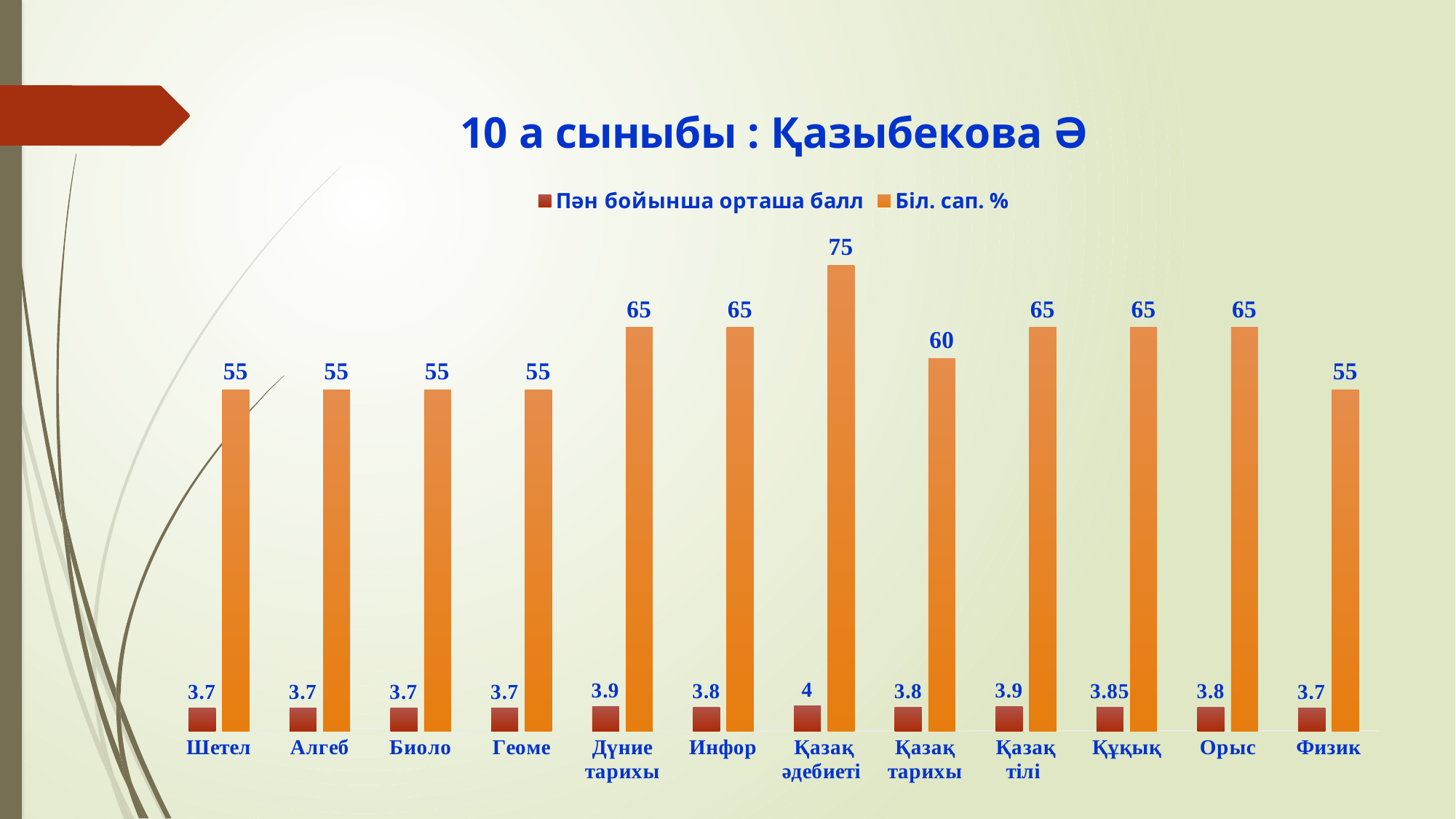
What is the value of "Пән бойынша орташа балл" for Құқық? 3.85 What is the title of the chart? 10 а сыныбы : Қазыбекова Ә What is the value of "Біл. сап. %" for Қазақ әдебиеті? 75 How many series does the legend list? 2 What is the value of "Біл. сап. %" for Қазақ тарихы? 60 How many categories are shown on the x axis? 12 Which category has the highest value for "Біл. сап. %"? Қазақ әдебиеті Which is larger, the "Біл. сап. %" value for Инфор or for Қазақ тарихы? Инфор What kind of chart is shown on the slide? Bar chart What is the difference between the "Біл. сап. %" values for Қазақ әдебиеті and Физик? 20 Which category has the highest value for "Пән бойынша орташа балл"? Қазақ әдебиеті What is the value of "Пән бойынша орташа балл" for Дүние тарихы? 3.9